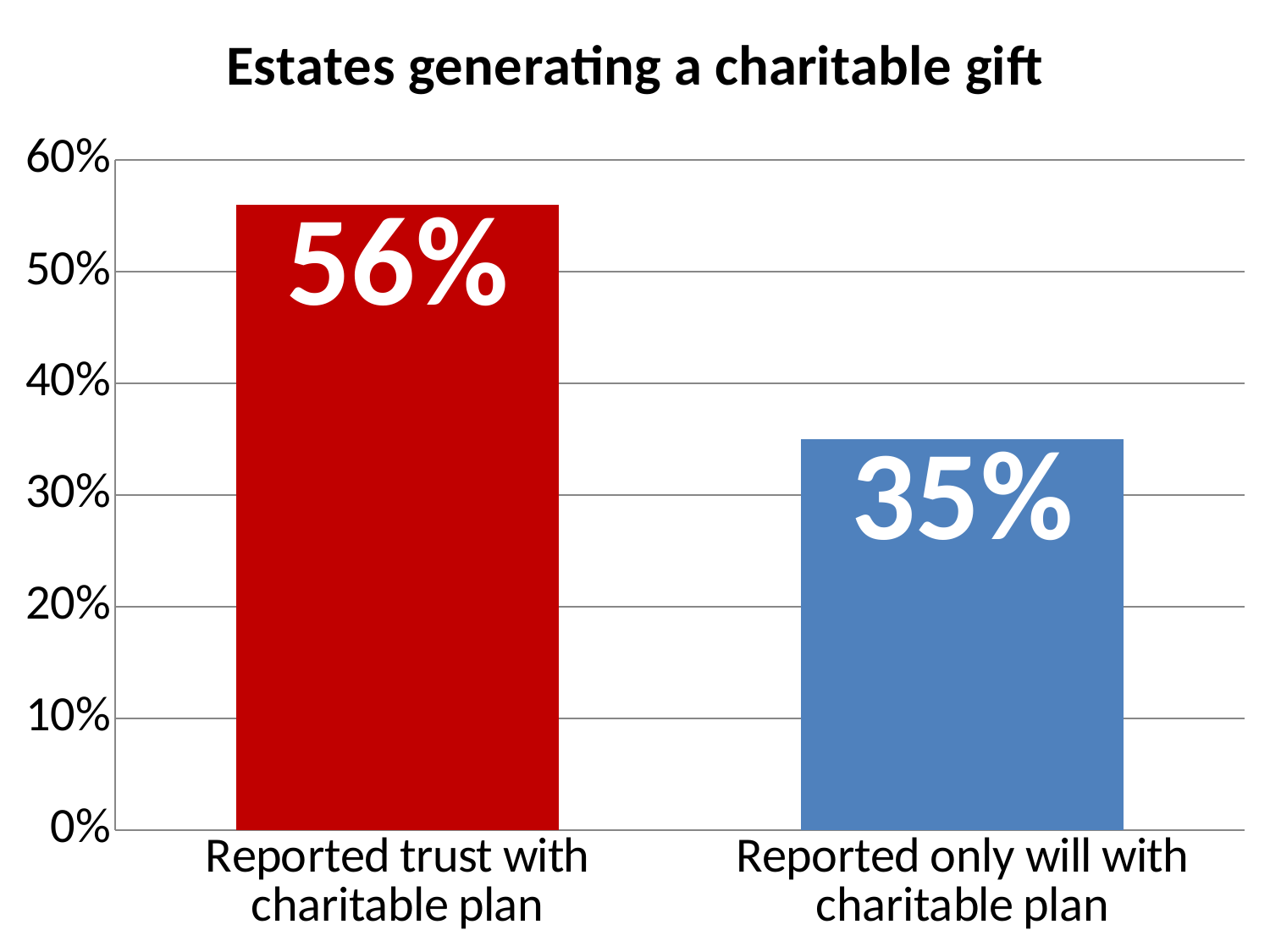
What colour is the bar for 'Reported only will with charitable plan'? Blue What is the difference in percentage points between the trust category and the will-only category? 21 How many categories are shown in the chart? 2 Which category has the lower percentage of estates generating a charitable gift? Reported only will with charitable plan What is the title of the chart? Estates generating a charitable gift Is the value for 'Reported only will with charitable plan' greater or less than 40%? less Which category has the higher percentage of estates generating a charitable gift? Reported trust with charitable plan What type of chart is shown on the slide? Bar chart Is the value for 'Reported trust with charitable plan' greater or less than 50%? greater What percentage of estates generated a charitable gift among those that reported only a will with a charitable plan? 35% Is the value for 'Reported trust with charitable plan' larger or smaller than the value for 'Reported only will with charitable plan'? larger What percentage of estates generated a charitable gift among those that reported a trust with a charitable plan? 56%